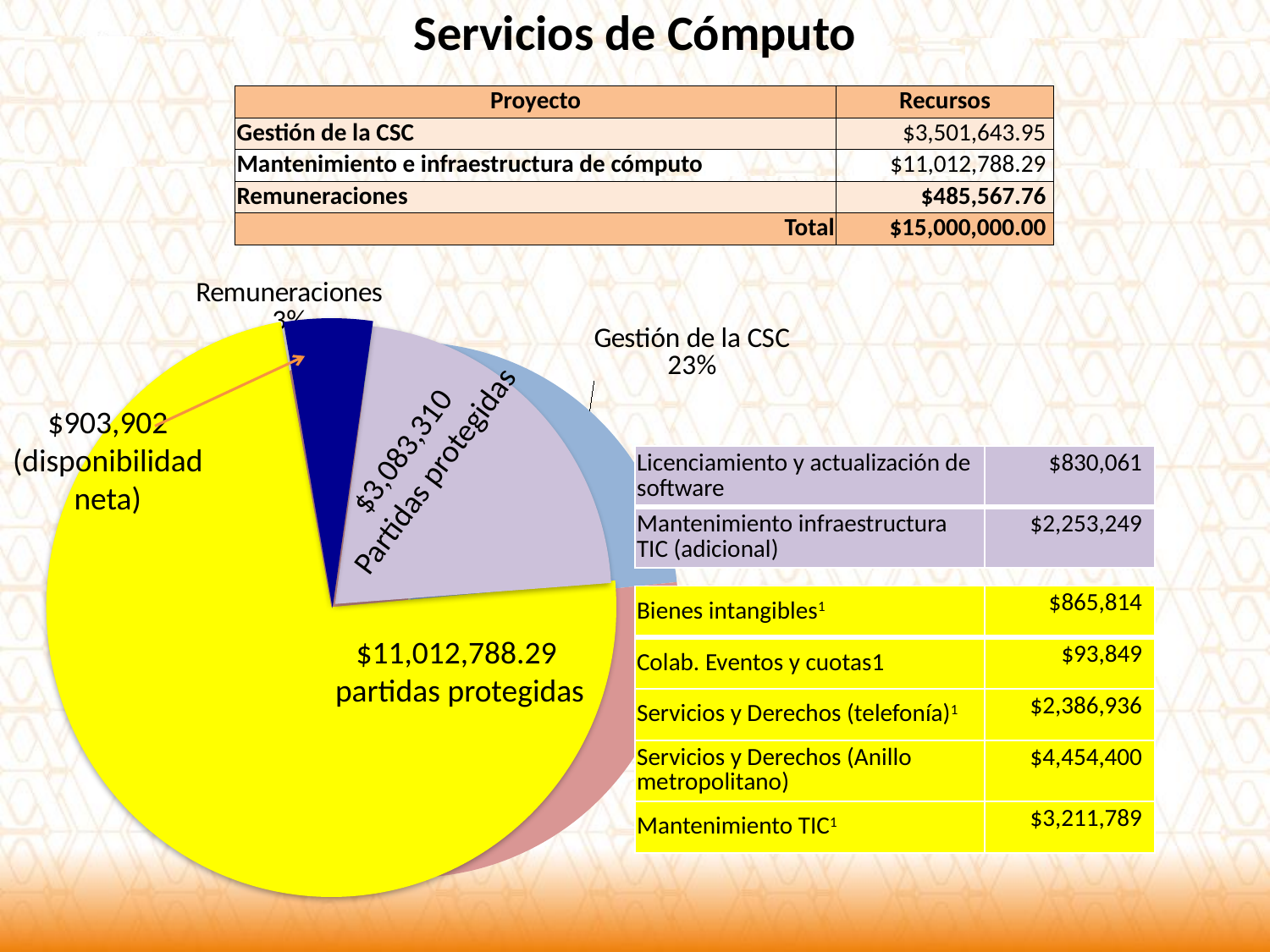
What colour is the Remuneraciones slice of the pie? dark blue Which slice is larger, Gestión de la CSC or Remuneraciones? Gestión de la CSC What amount is labelled 'partidas protegidas' on the large yellow area of the chart? $11,012,788.29 What amount is written on the lavender wedge labelled 'Partidas protegidas'? $3,083,310 What is the difference in percentage points between the Gestión de la CSC share and the Remuneraciones share? 20 What kind of chart is shown on the slide? pie chart What is the title of the slide containing the pie chart? Servicios de Cómputo What amount is labelled on the chart as 'disponibilidad neta'? $903,902 What share of the pie does Gestión de la CSC represent? 23% Which labelled slice of the pie has the smallest share? Remuneraciones What share of the pie does Remuneraciones represent? 3%